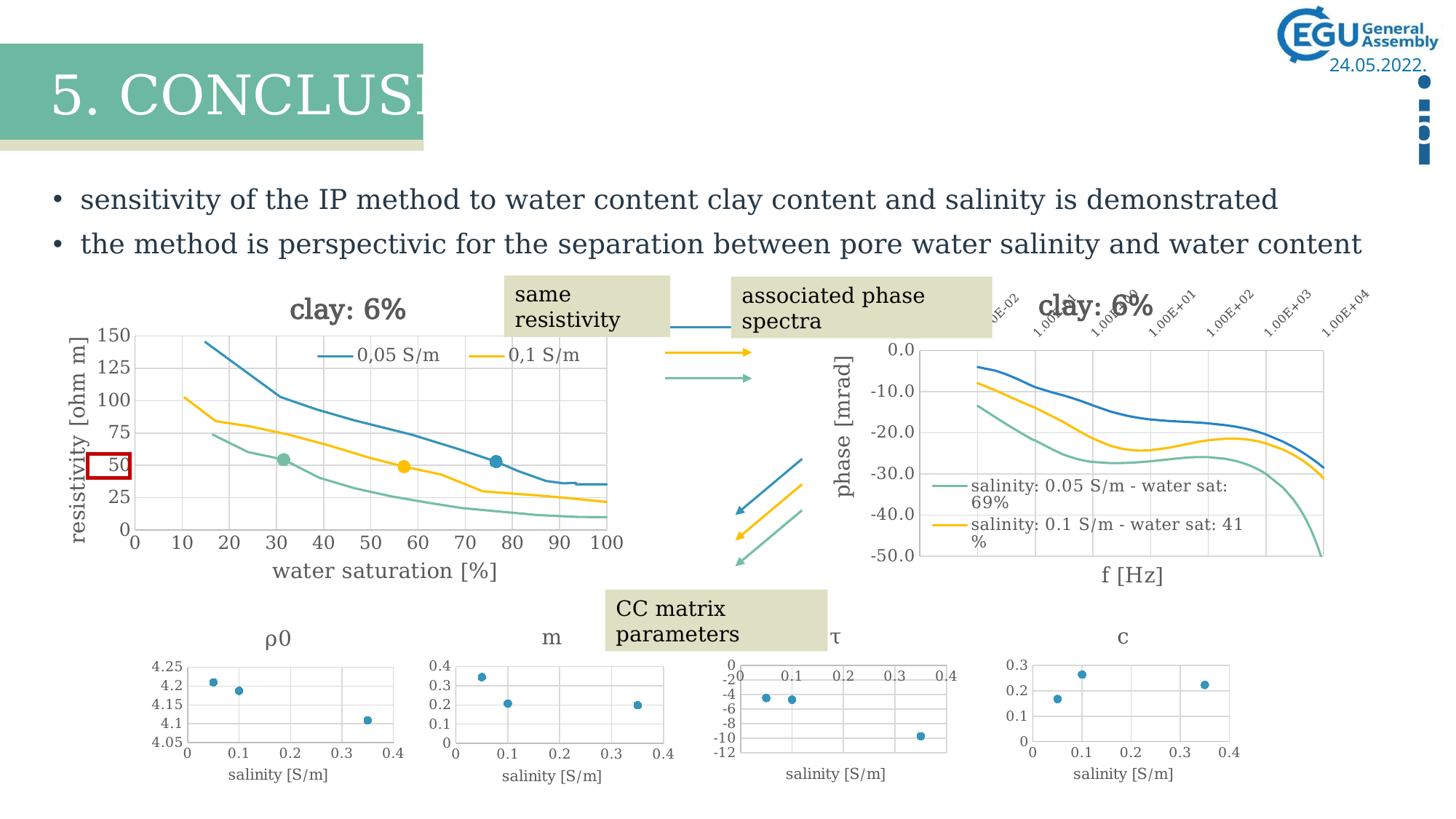
What kind of chart is the top-left 'clay: 6%' chart of resistivity versus water saturation? line chart How many series does the legend of the top-right phase spectra chart list? 2 In the bottom τ chart, is the value at a salinity of 0.35 S/m greater or less than -8? less What is the x-axis label of the top-right phase spectra chart? f [Hz] How many data points are plotted in the bottom ρ0 chart? 3 In the top-left resistivity chart, is the 0,05 S/m value at a water saturation of 20% greater or less than 100? greater In the bottom m chart, is the value at a salinity of 0.05 S/m greater or less than 0.3? greater In the top-left resistivity chart, does the 0,05 S/m line rise or fall as water saturation increases? fall In the top-left resistivity chart, which series has the higher resistivity at a water saturation of 50%, 0,05 S/m or 0,1 S/m? 0,05 S/m How many series does the legend of the top-left resistivity chart list? 2